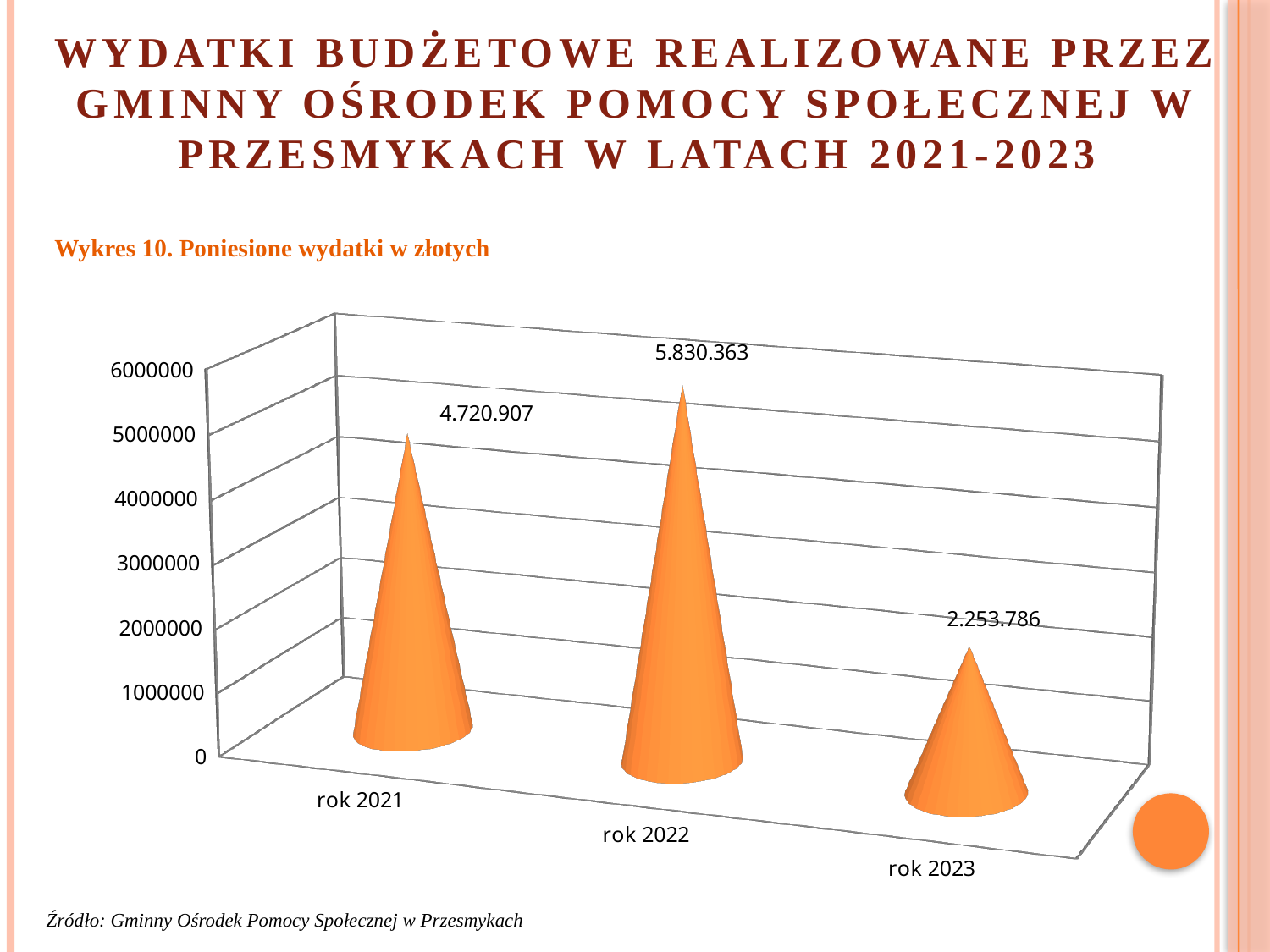
What is the title of the chart (Wykres 10)? Poniesione wydatki w złotych What is the value for rok 2022? 5.830.363 Which year has the lowest expenditure? rok 2023 Is the value for rok 2023 greater or less than 3000000? less Which is larger, the value for rok 2021 or rok 2023? rok 2021 What is the value for rok 2021? 4.720.907 What kind of chart is shown on the slide? bar chart What is the difference between the values for rok 2022 and rok 2021? 1.109.456 What is the value for rok 2023? 2.253.786 How many years are shown on the chart? 3 Which year has the highest expenditure? rok 2022 What is the difference between the values for rok 2021 and rok 2023? 2.467.121